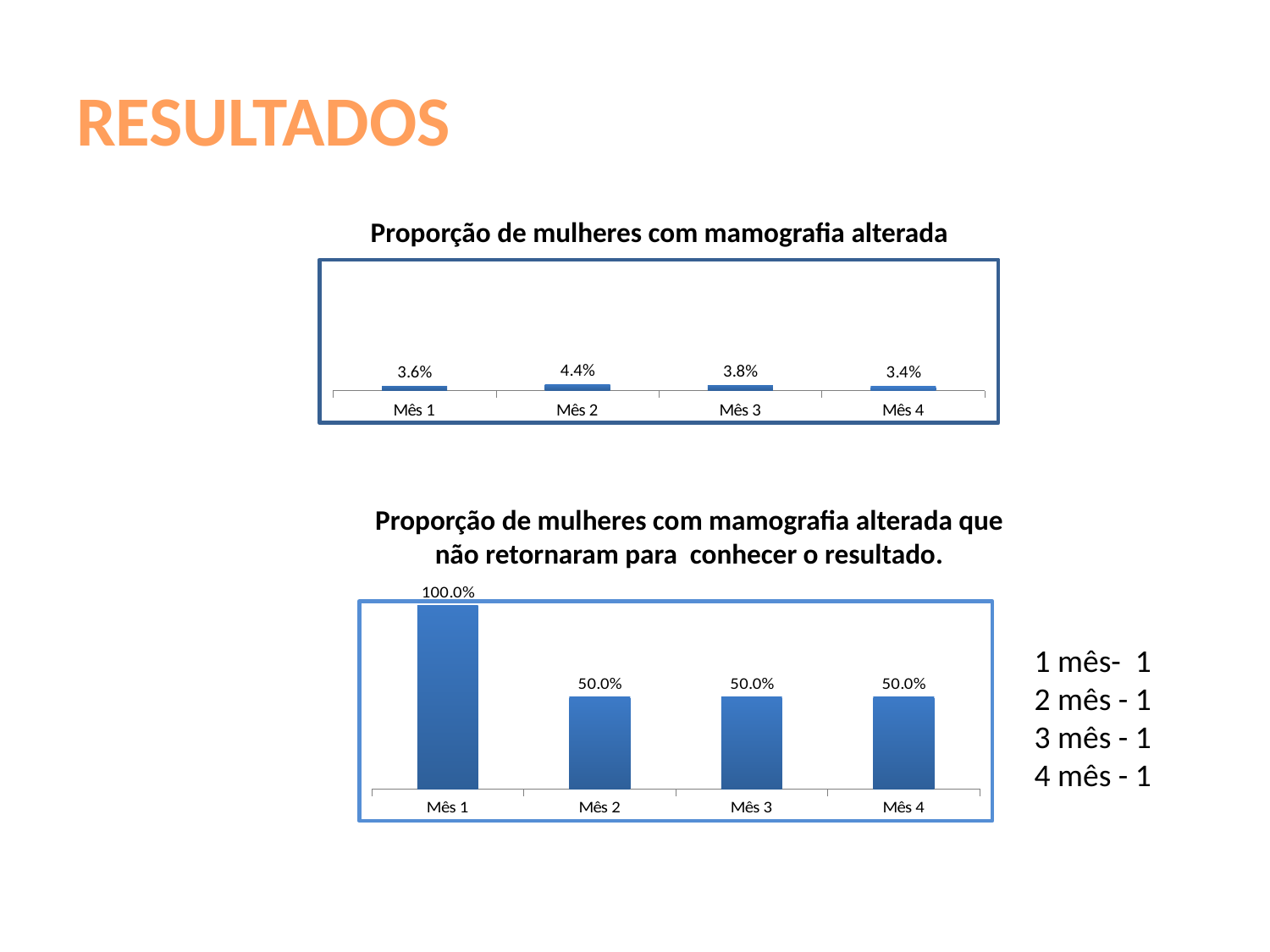
In the top chart 'Proporção de mulheres com mamografia alterada', which month has the lowest value? Mês 4 In the bottom chart 'Proporção de mulheres com mamografia alterada que não retornaram para conhecer o resultado', what is the difference between the values for Mês 1 and Mês 2? 50.0% In the top chart 'Proporção de mulheres com mamografia alterada', what is the value for Mês 4? 3.4% In the bottom chart 'Proporção de mulheres com mamografia alterada que não retornaram para conhecer o resultado', is the value for Mês 1 larger or smaller than the value for Mês 4? larger In the bottom chart 'Proporção de mulheres com mamografia alterada que não retornaram para conhecer o resultado', which month has the highest value? Mês 1 In the top chart 'Proporção de mulheres com mamografia alterada', what is the difference between the values for Mês 2 and Mês 1? 0.8% In the bottom chart 'Proporção de mulheres com mamografia alterada que não retornaram para conhecer o resultado', what is the value for Mês 3? 50.0% In the top chart 'Proporção de mulheres com mamografia alterada', what is the value for Mês 2? 4.4% In the top chart 'Proporção de mulheres com mamografia alterada', how many months are shown on the x axis? 4 What type of chart is the bottom chart on the slide? bar chart In the top chart 'Proporção de mulheres com mamografia alterada', which month has the highest value? Mês 2 In the bottom chart 'Proporção de mulheres com mamografia alterada que não retornaram para conhecer o resultado', what is the value for Mês 1? 100.0%